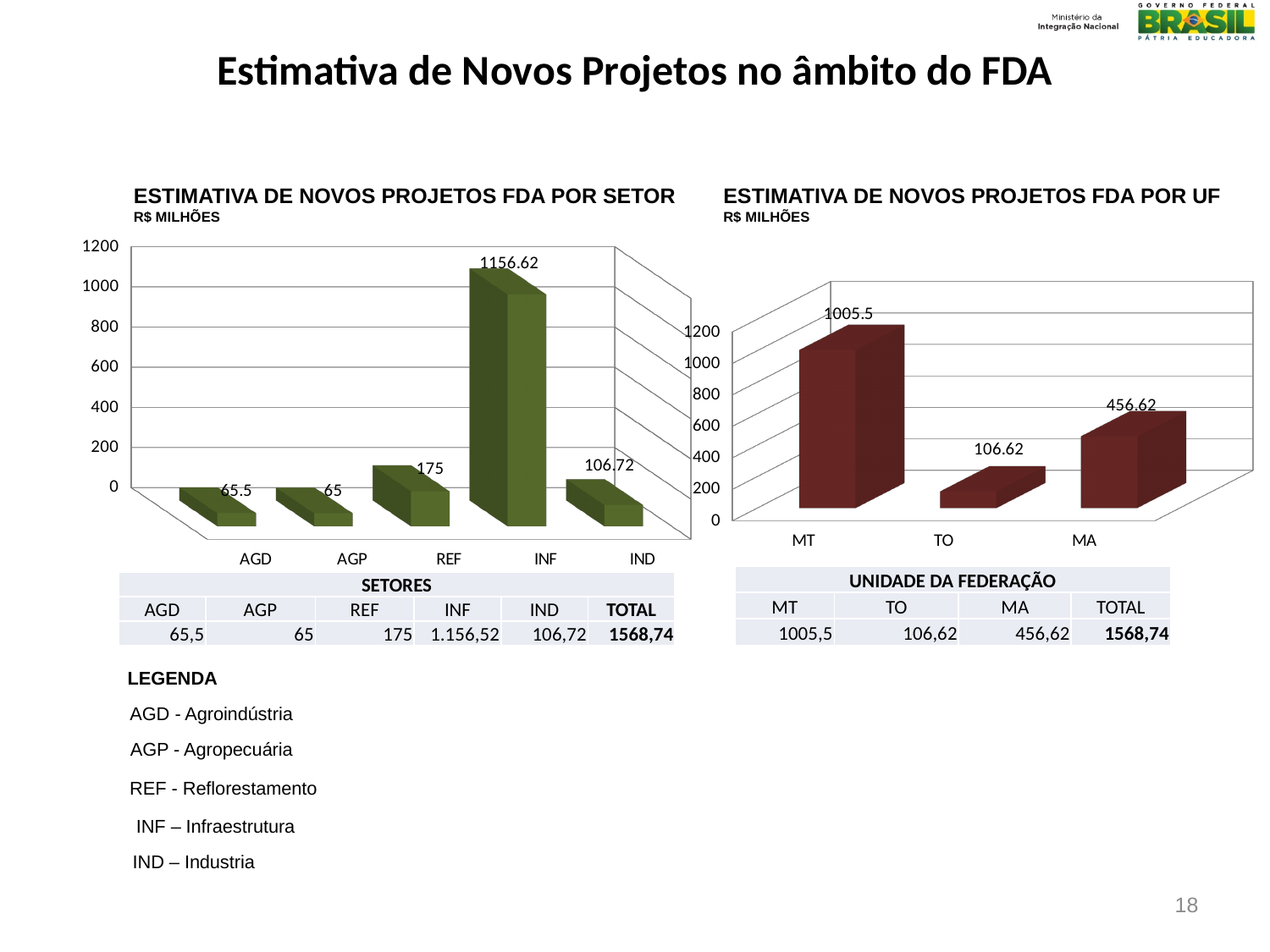
In the chart 'ESTIMATIVA DE NOVOS PROJETOS FDA POR UF', which state has the lowest value? TO In the chart 'ESTIMATIVA DE NOVOS PROJETOS FDA POR SETOR', what is the difference between the values for REF and IND? 68.28 In the chart 'ESTIMATIVA DE NOVOS PROJETOS FDA POR UF', what is the value for MA? 456.62 In the chart 'ESTIMATIVA DE NOVOS PROJETOS FDA POR SETOR', which is larger, the value for IND or the value for AGP? IND In the chart 'ESTIMATIVA DE NOVOS PROJETOS FDA POR SETOR', what is the value for REF? 175 In the chart 'ESTIMATIVA DE NOVOS PROJETOS FDA POR SETOR', which sector has the highest value? INF In the chart 'ESTIMATIVA DE NOVOS PROJETOS FDA POR UF', what is the difference between the values for MT and MA? 548.88 In the chart 'ESTIMATIVA DE NOVOS PROJETOS FDA POR UF', what is the value for MT? 1005.5 In the chart 'ESTIMATIVA DE NOVOS PROJETOS FDA POR SETOR', what is the value for INF? 1156.62 In the chart 'ESTIMATIVA DE NOVOS PROJETOS FDA POR UF', how many states are plotted? 3 What type of chart is 'ESTIMATIVA DE NOVOS PROJETOS FDA POR UF'? Bar chart In the chart 'ESTIMATIVA DE NOVOS PROJETOS FDA POR SETOR', how many sectors are plotted? 5